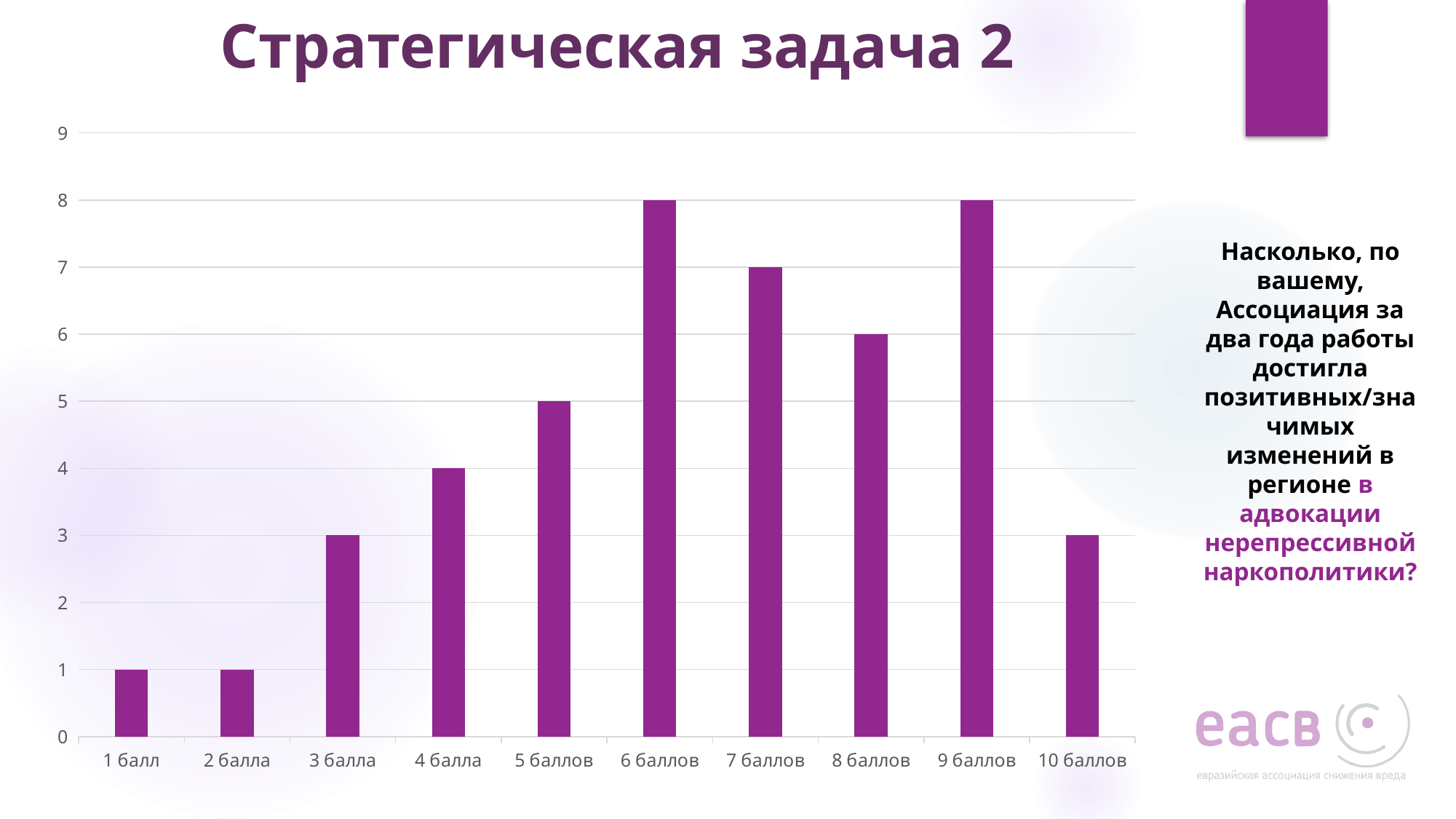
What kind of chart is shown on the slide? bar chart What is the value for 3 балла? 3 Is the value for 8 баллов greater or less than 5? greater What is the value for 10 баллов? 3 What is the value for 6 баллов? 8 Which is larger, the value for 5 баллов or the value for 4 балла? 5 баллов Do the values rise or fall from 1 балл to 6 баллов? rise What is the difference between the values for 9 баллов and 8 баллов? 2 What is the value for 7 баллов? 7 What is the title of the slide containing the chart? Стратегическая задача 2 What is the value for 1 балл? 1 How many categories are shown on the x axis of the chart? 10